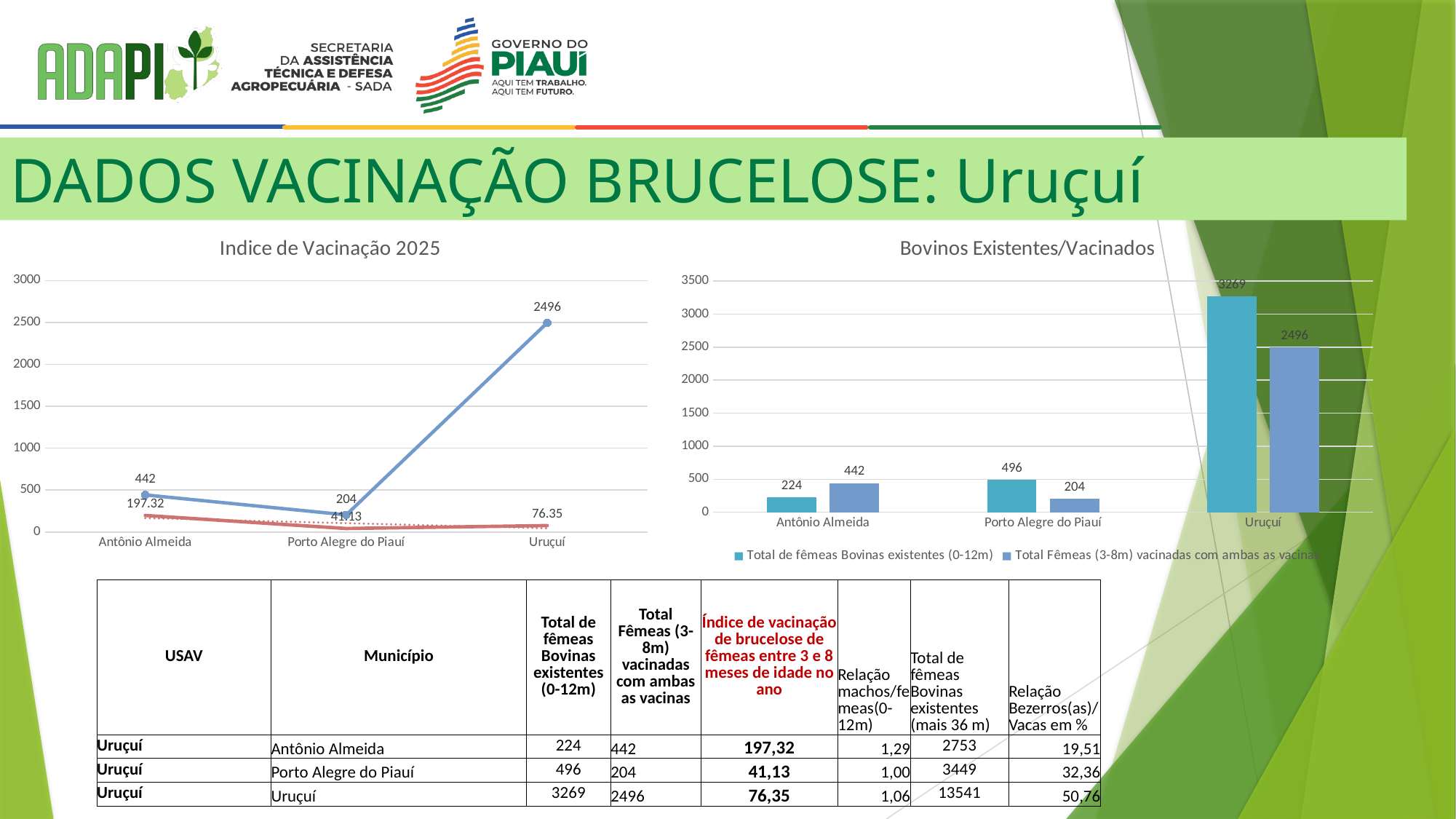
In the 'Bovinos Existentes/Vacinados' chart, what is the value of 'Total de fêmeas Bovinas existentes (0-12m)' for Uruçuí? 3269 What kind of chart is 'Bovinos Existentes/Vacinados'? Bar chart What kind of chart is 'Indice de Vacinação 2025'? Line chart In the 'Bovinos Existentes/Vacinados' chart, what is the value of 'Total Fêmeas (3-8m) vacinadas com ambas as vacinas' for Porto Alegre do Piauí? 204 In the 'Indice de Vacinação 2025' chart, what is the value of the red line for Porto Alegre do Piauí? 41.13 How many municipalities are shown on the x axis of the 'Indice de Vacinação 2025' chart? 3 In the 'Bovinos Existentes/Vacinados' chart, which municipality has the lowest value for 'Total Fêmeas (3-8m) vacinadas com ambas as vacinas'? Porto Alegre do Piauí How many series does the legend of the 'Bovinos Existentes/Vacinados' chart list? 2 In the 'Bovinos Existentes/Vacinados' chart, for Antônio Almeida, which is larger: 'Total de fêmeas Bovinas existentes (0-12m)' or 'Total Fêmeas (3-8m) vacinadas com ambas as vacinas'? Total Fêmeas (3-8m) vacinadas com ambas as vacinas In the 'Indice de Vacinação 2025' chart, what is the value of the blue line for Uruçuí? 2496 In the 'Bovinos Existentes/Vacinados' chart, which municipality has the highest value for 'Total de fêmeas Bovinas existentes (0-12m)'? Uruçuí In the 'Bovinos Existentes/Vacinados' chart, what is the difference between the two bars for Uruçuí? 773